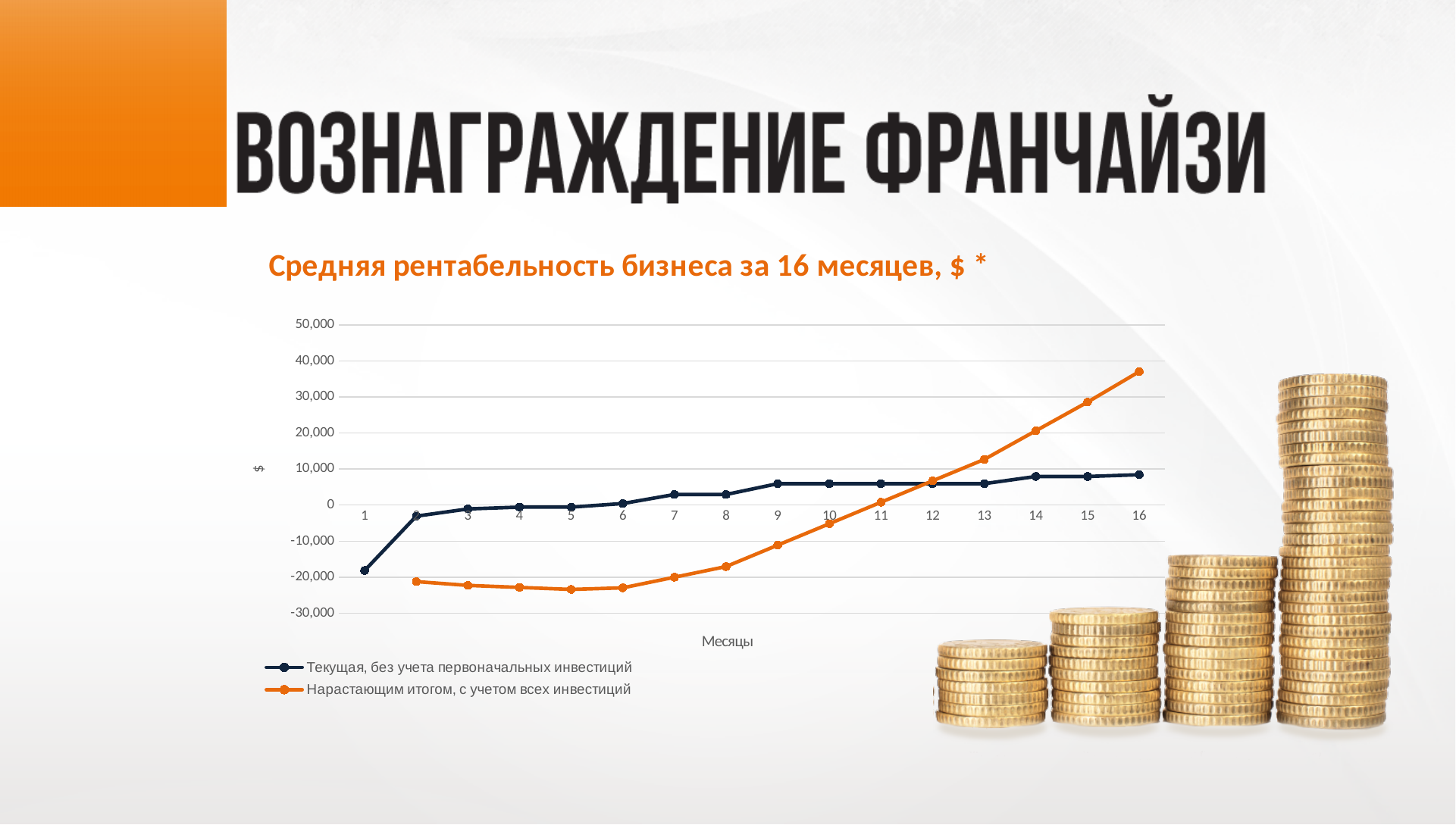
Is the value of the series 'Нарастающим итогом, с учетом всех инвестиций' at month 5 greater or less than -20,000? less At month 16, which series has the larger value: 'Текущая, без учета первоначальных инвестиций' or 'Нарастающим итогом, с учетом всех инвестиций'? Нарастающим итогом, с учетом всех инвестиций What is the label of the x axis? Месяцы At month 5, which series has the larger value: 'Текущая, без учета первоначальных инвестиций' or 'Нарастающим итогом, с учетом всех инвестиций'? Текущая, без учета первоначальных инвестиций What is the title of the chart? Средняя рентабельность бизнеса за 16 месяцев, $ * What kind of chart is shown on the slide? line chart How many months are shown on the x axis of the chart? 16 How many series does the legend list? 2 Is the value of the series 'Текущая, без учета первоначальных инвестиций' at month 16 greater or less than 10,000? less Is the value of the series 'Нарастающим итогом, с учетом всех инвестиций' at month 16 greater or less than 30,000? greater In which month does the series 'Нарастающим итогом, с учетом всех инвестиций' reach its highest value? 16